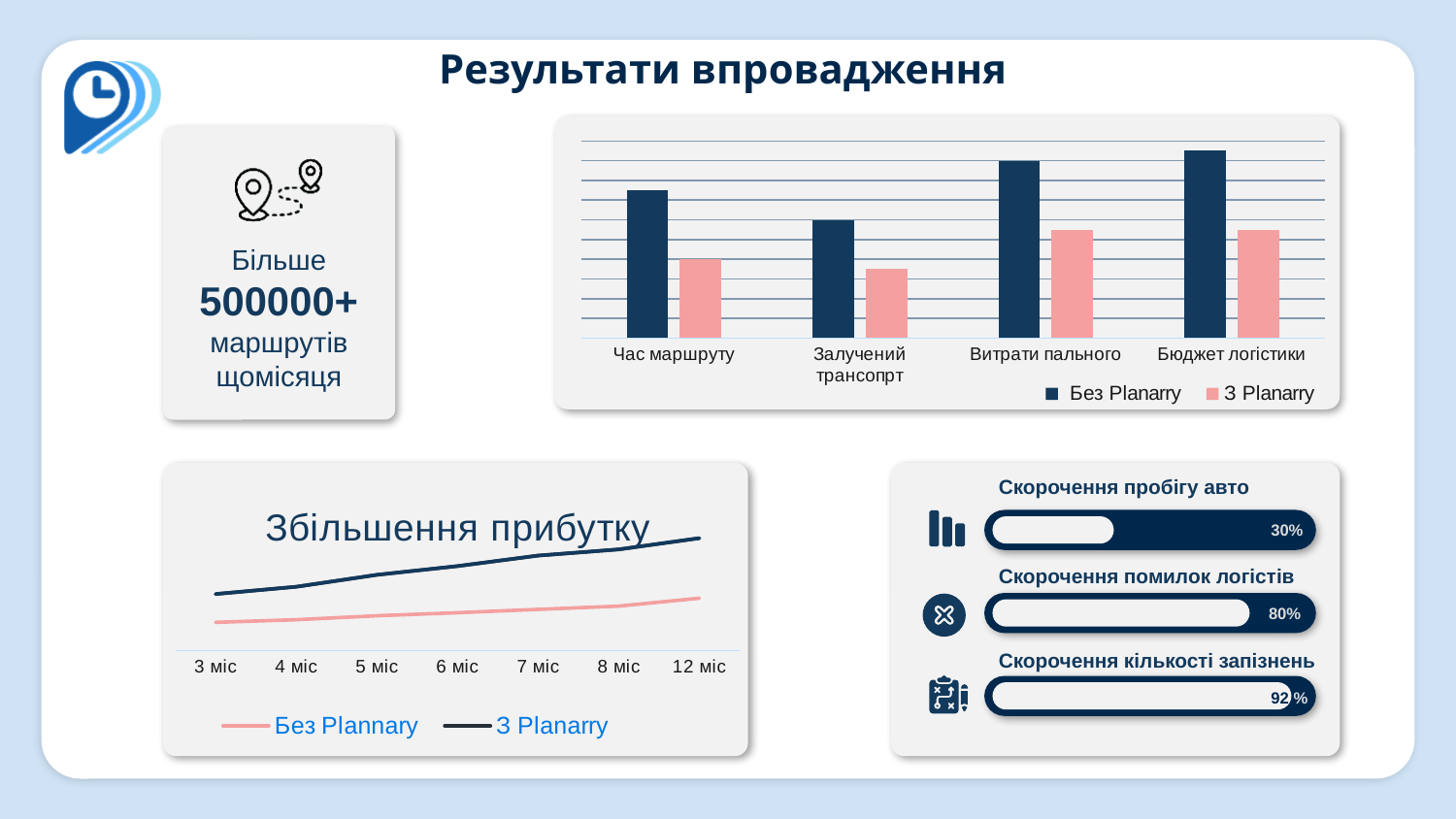
In the bottom-left chart 'Збільшення прибутку', does the З Planarry line rise or fall from 3 міс to 12 міс? rise In the top-right bar chart, for Час маршруту, which series has the larger value: Без Planarry or З Planarry? Без Planarry In the top-right bar chart, which category has the highest value for Без Planarry? Бюджет логістики How many categories does the top-right bar chart show? 4 How many series does the legend of the top-right bar chart list? 2 In the top-right bar chart, which category has the lowest value for З Planarry? Залучений трансопрт What type of chart is the top-right chart on the slide? bar chart In the top-right bar chart, which category has the lowest value for Без Planarry? Залучений трансопрт What is the title of the bottom-left line chart? Збільшення прибутку In the bottom-left chart 'Збільшення прибутку', which series is higher at 12 міс: Без Plannary or З Planarry? З Planarry In the top-right bar chart, which colour represents the З Planarry series? pink In the bottom-left chart 'Збільшення прибутку', how many points are on the x axis? 7